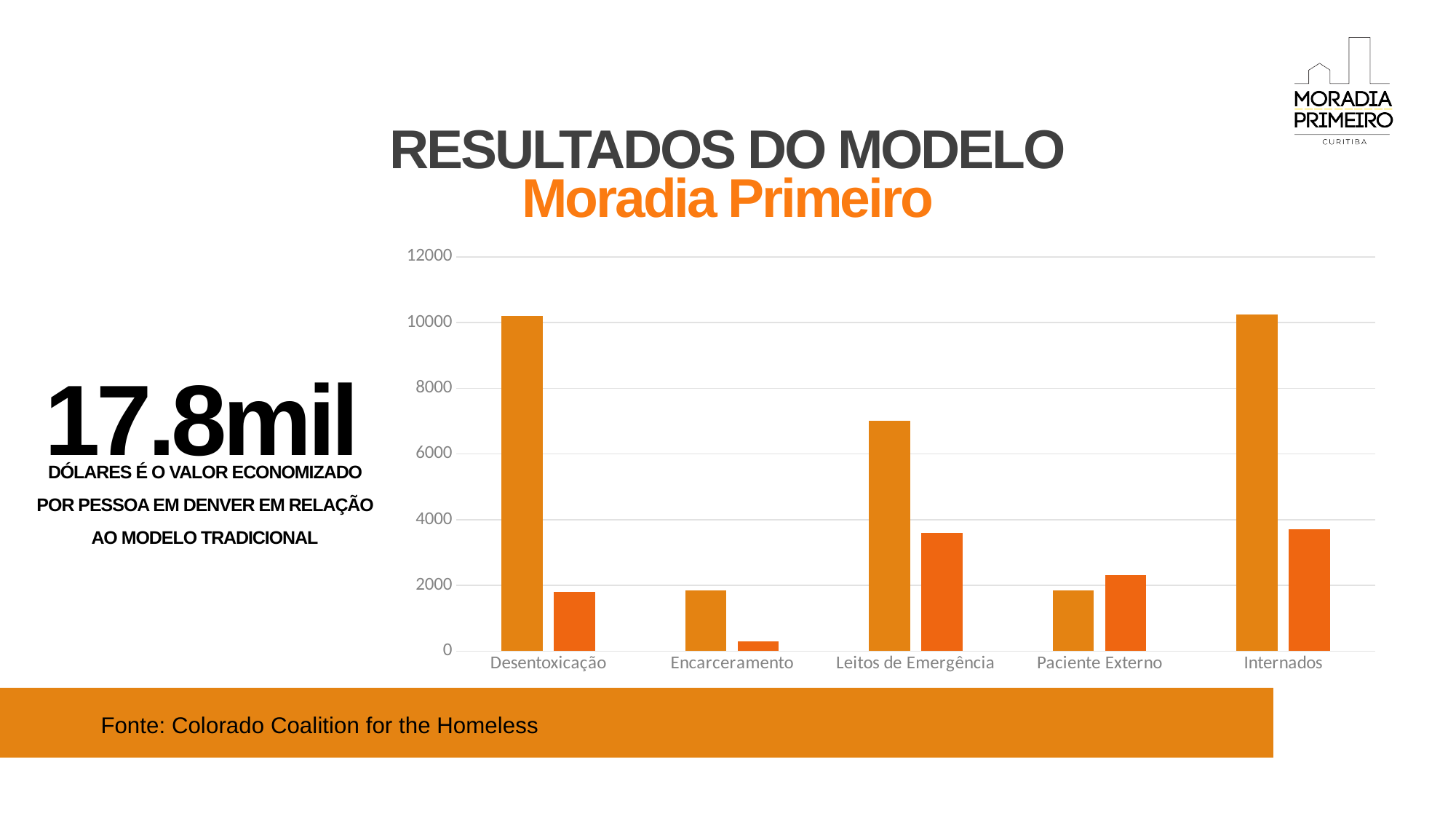
Which category has the lowest bar in the chart? Encarceramento What kind of chart is shown on the slide? bar chart What source is cited for the chart data on the slide? Colorado Coalition for the Homeless Is the value of the second (darker orange) bar for Paciente Externo greater or less than 4000? less Is the value of the second (darker orange) bar for Internados greater or less than 2000? greater Which is larger: the first (lighter orange) bar for Leitos de Emergência or the first (lighter orange) bar for Paciente Externo? Leitos de Emergência For Desentoxicação, which bar is larger: the first (lighter orange) or the second (darker orange)? the first (lighter orange) Is the value of the first (lighter orange) bar for Leitos de Emergência greater or less than 6000? greater How many categories are shown on the x axis of the chart? 5 How many bars are plotted for each category in the chart? 2